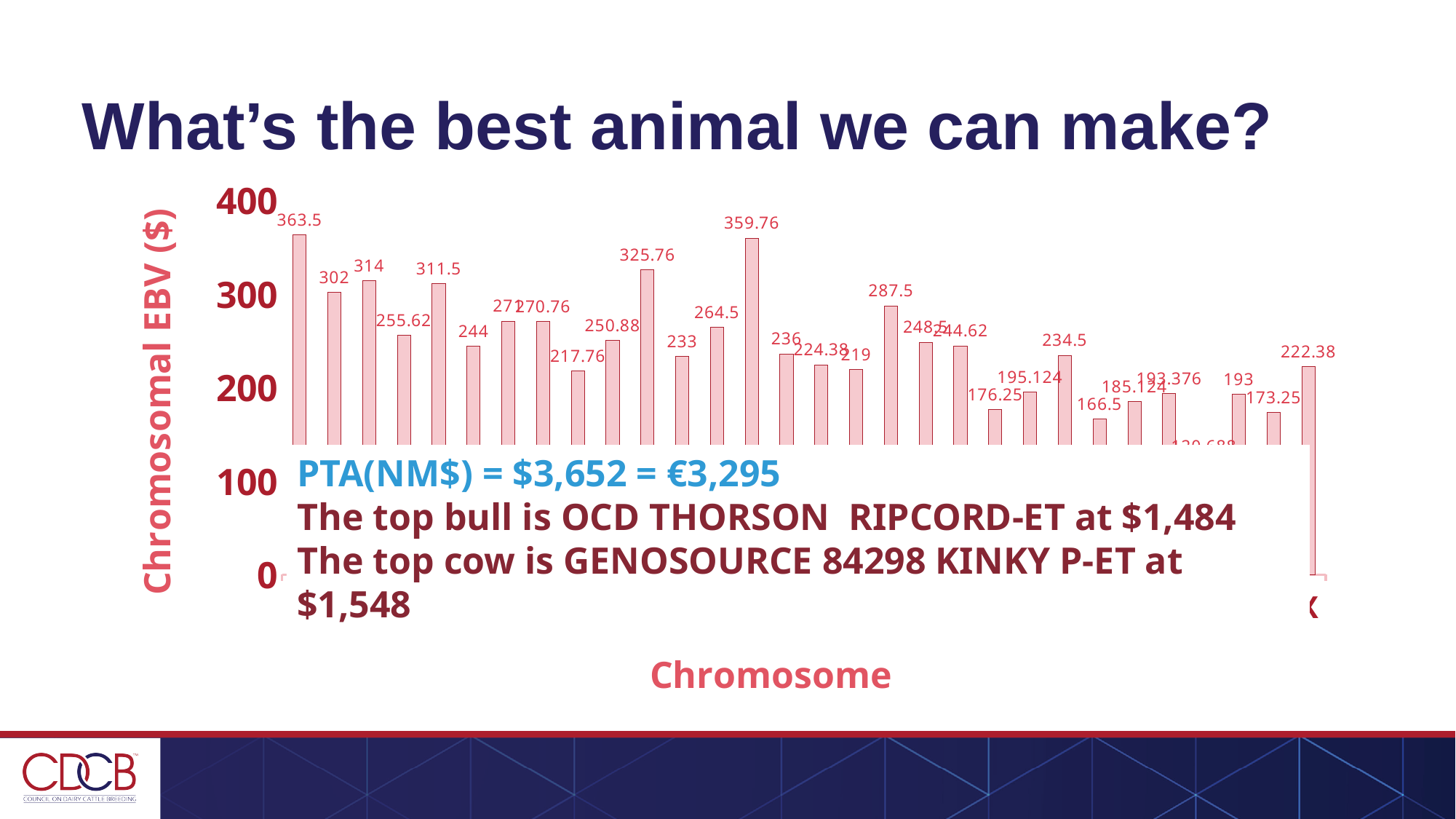
What is the title of the horizontal axis of the chart? Chromosome What is the difference between the two highest labelled bar values, 363.5 and 359.76? 3.74 Is the value of the rightmost bar greater or less than 300? less What is the title of the vertical axis of the chart? Chromosomal EBV ($) How many bars in the chart have a labelled value above 300? 6 What is the value labelled on the leftmost bar of the chart? 363.5 Is the value of the leftmost bar greater or less than 300? greater What is the second-highest value labelled on a bar in the chart? 359.76 What is the highest value labelled on any bar in the chart? 363.5 What kind of chart is shown on the slide? bar chart What is the value labelled on the rightmost bar of the chart? 222.38 Which is larger: the leftmost bar (363.5) or the rightmost bar (222.38)? the leftmost bar (363.5)